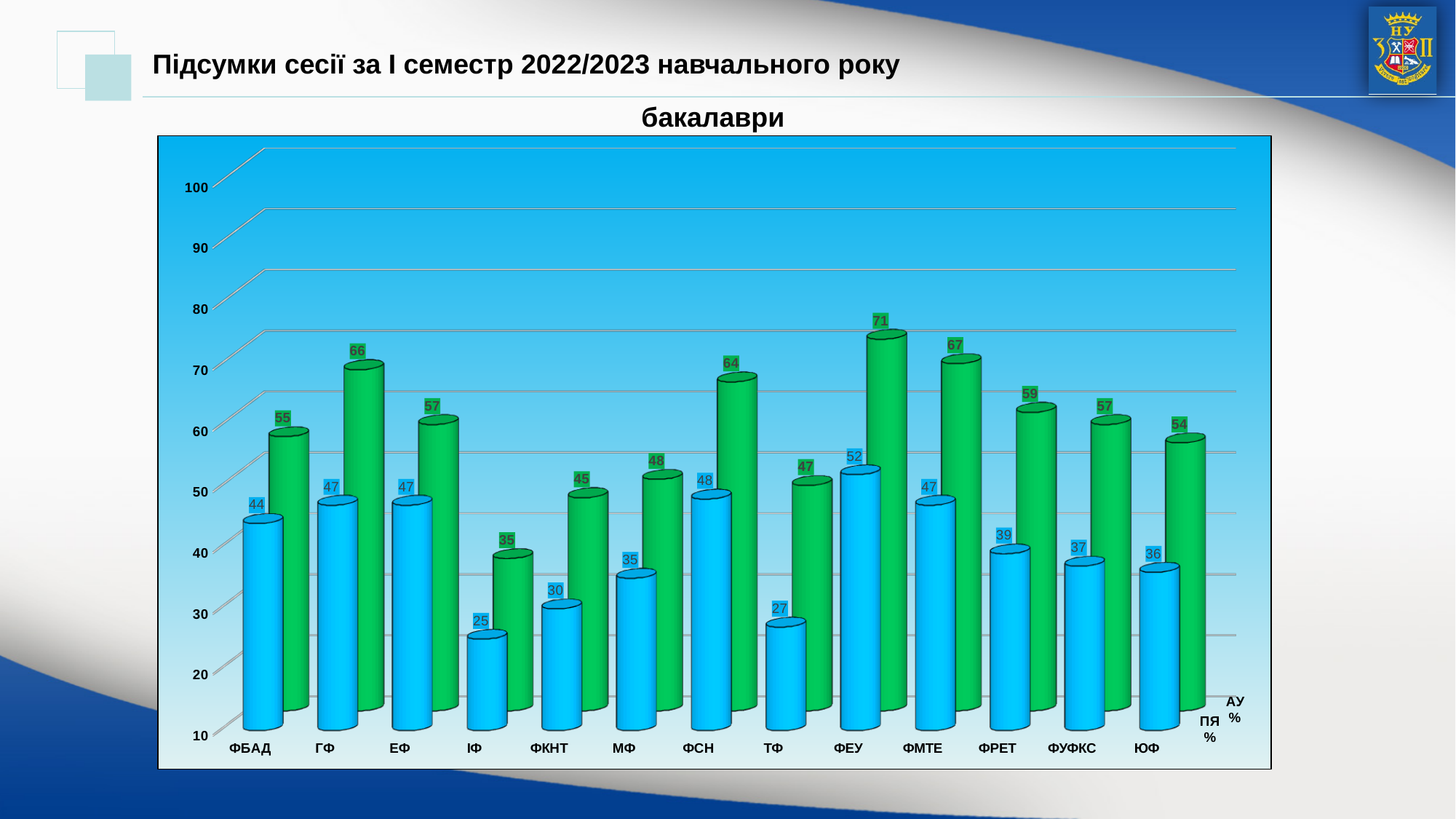
How many faculties are shown on the x axis of the chart? 13 What is the АУ % value for ГФ? 66 What is the АУ % value for ТФ? 47 Which faculty has the highest ПЯ % value? ФЕУ Which faculty has the highest АУ % value? ФЕУ What is the ПЯ % value for ФЕУ? 52 What is the difference between the АУ % values for ФЕУ and ФМТЕ? 4 Which has the larger ПЯ % value, ФБАД or ФРЕТ? ФБАД What type of chart is shown on the slide? bar chart How many data series are plotted in the chart? 2 Which faculty has the lowest ПЯ % value? ІФ What is the difference between the АУ % and ПЯ % values for ФСН? 16